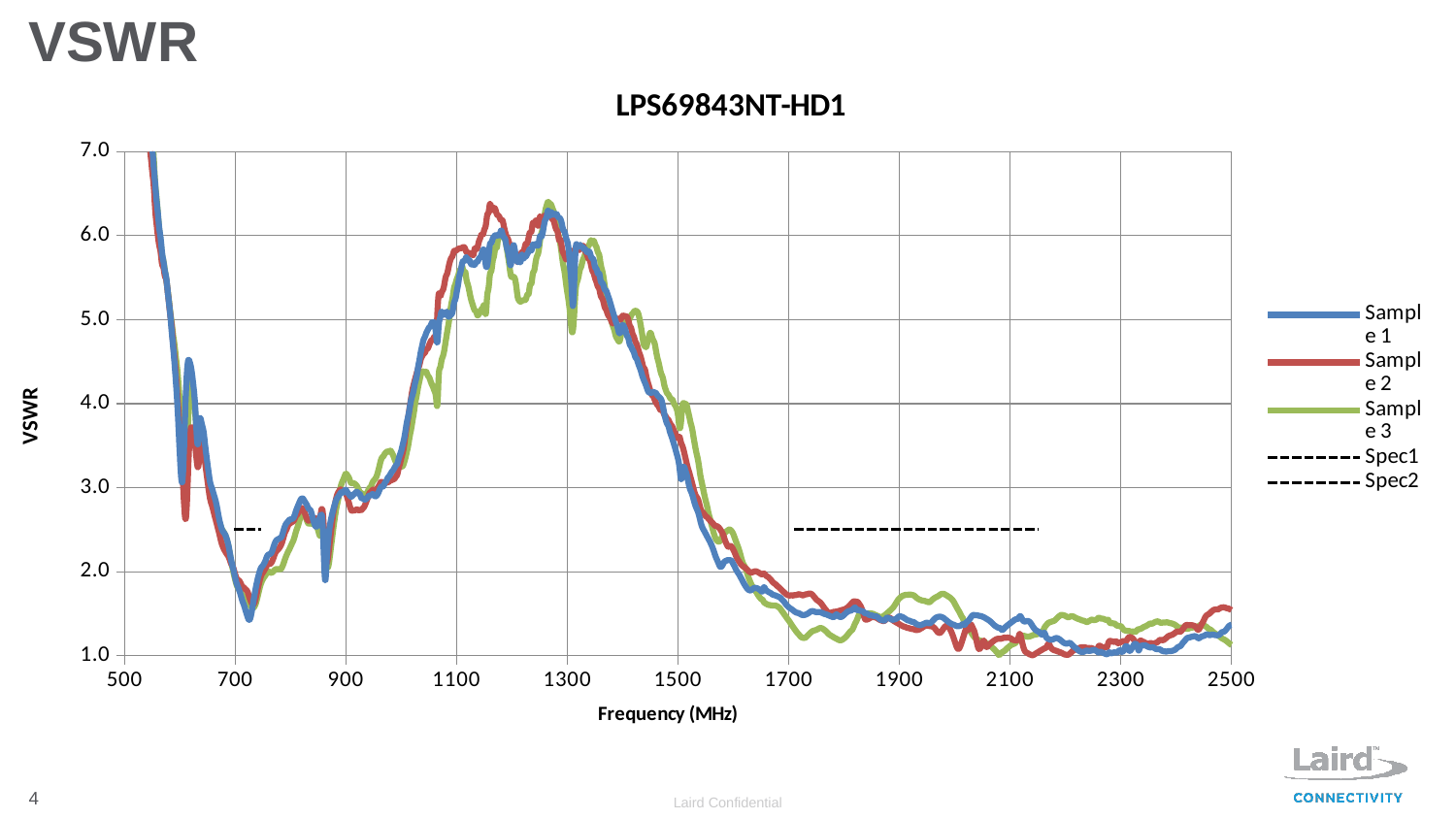
Between 900 MHz and 1300 MHz, do the VSWR values of the samples rise or fall? rise Is the peak VSWR value of Sample 3 greater or less than 6.0? greater What kind of chart is shown on the slide? Line chart Is the VSWR value for Sample 2 at 1100 MHz greater or less than 5.0? greater What is the label of the x axis? Frequency (MHz) Is the VSWR value for Sample 1 at 1700 MHz greater or less than 2.0? less What is the title of the chart? LPS69843NT-HD1 Between 1300 MHz and 1700 MHz, do the VSWR values of the samples rise or fall? fall How many series does the legend list? 5